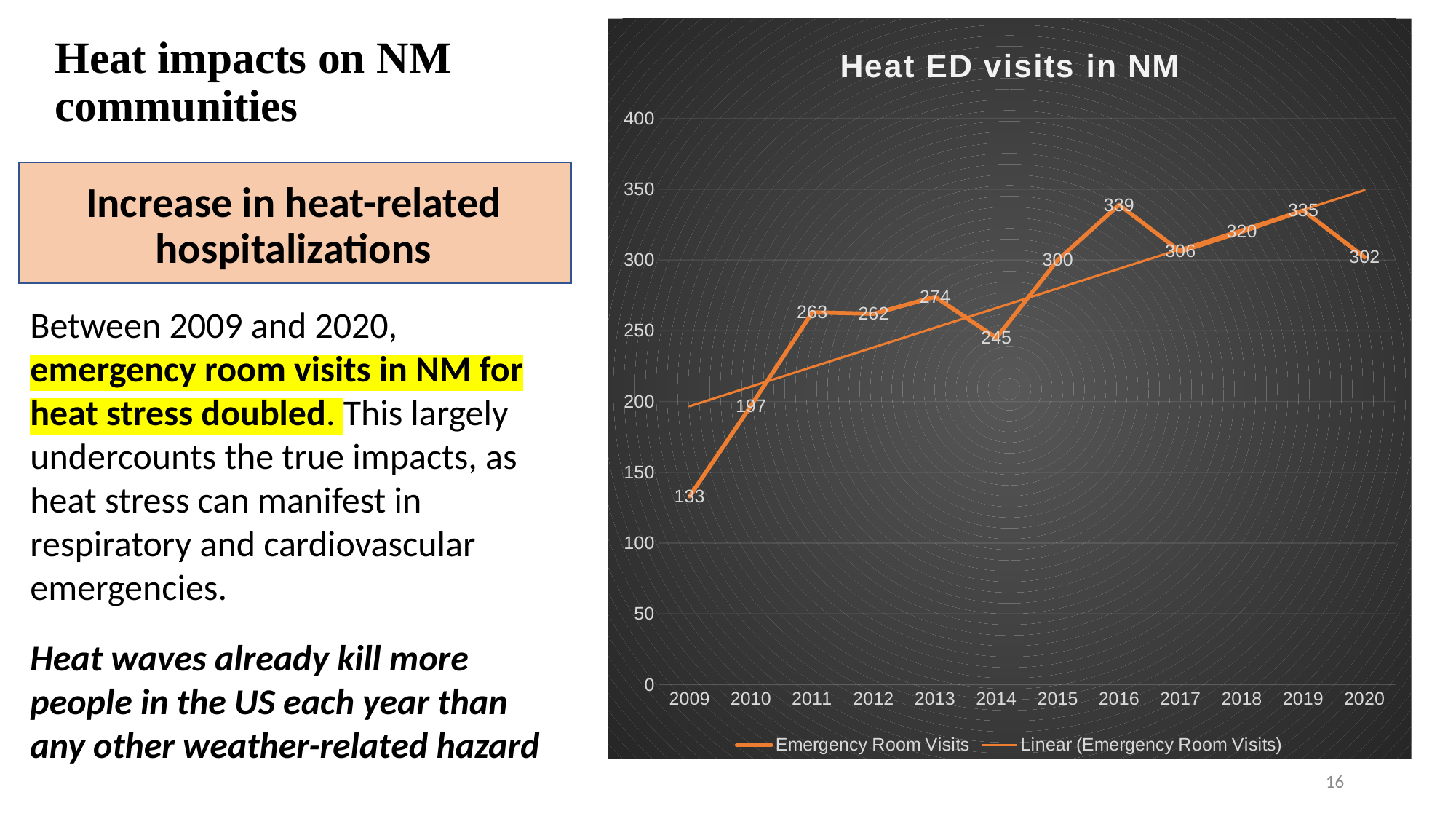
Which year has the highest number of Emergency Room Visits? 2016 What is the difference in Emergency Room Visits between 2016 and 2009? 206 What is the value for Emergency Room Visits in 2009? 133 What kind of chart is shown? line chart How many years are shown on the x axis? 12 Which year has the lowest number of Emergency Room Visits? 2009 What is the title of the chart? Heat ED visits in NM What is the value for Emergency Room Visits in 2020? 302 Is the value for Emergency Room Visits in 2010 greater or less than 200? less Which year has more Emergency Room Visits, 2013 or 2014? 2013 What is the value for Emergency Room Visits in 2016? 339 How many entries does the legend list? 2